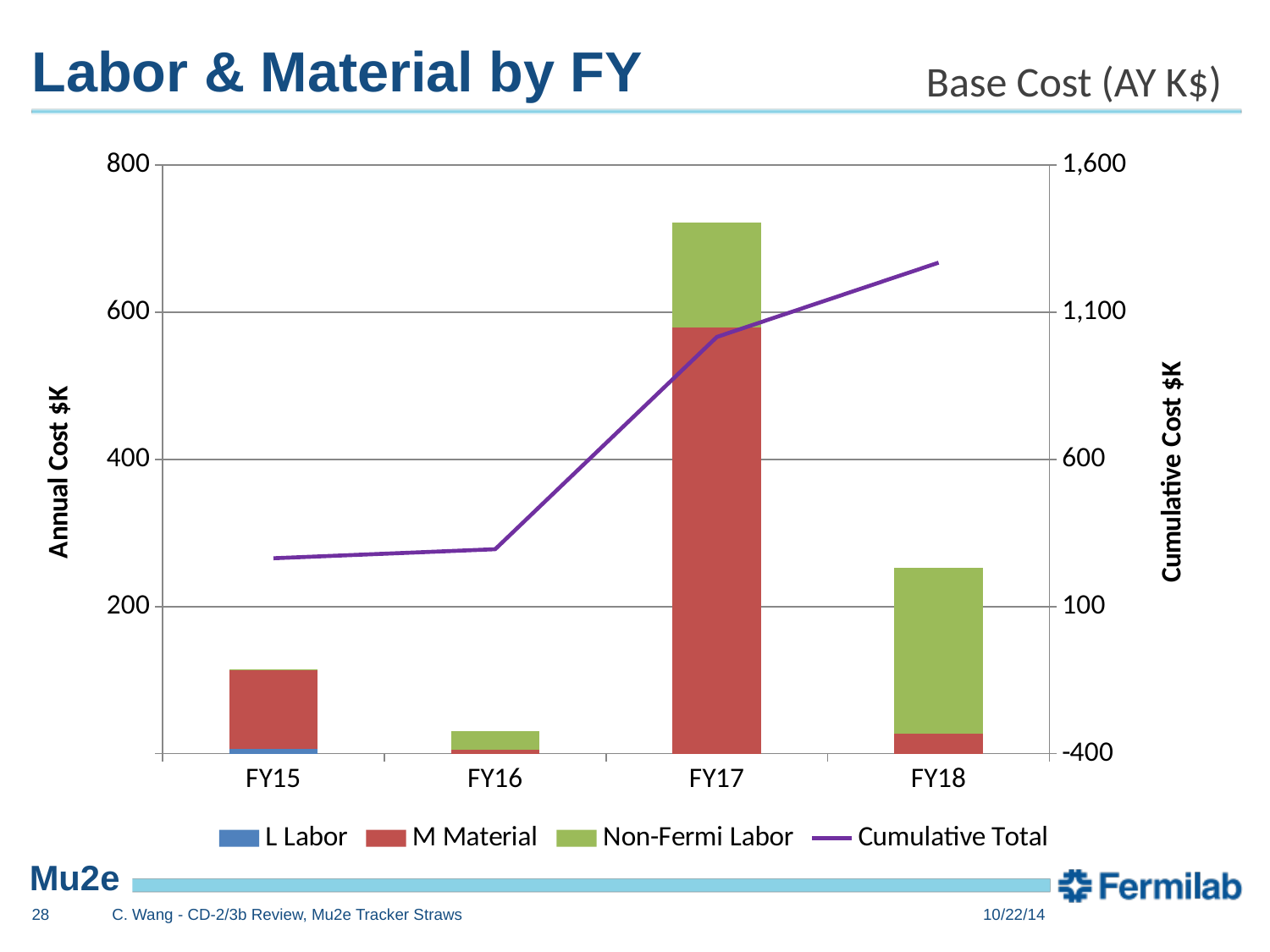
How many series does the legend list? 4 Which fiscal year has the shortest stacked bar? FY16 Is the total annual cost for FY18 greater or less than 200? greater Which fiscal year has the tallest stacked bar? FY17 Which has the larger total annual cost, FY15 or FY18? FY18 Is the total annual cost for FY15 greater or less than 200? less Does the Cumulative Total line rise or fall from FY15 to FY18? rise Which series makes up the largest part of the FY17 bar? M Material Is the total annual cost for FY17 greater or less than 600? greater How many fiscal years are shown on the x axis? 4 What kind of chart is shown on the slide? Stacked bar chart with a line